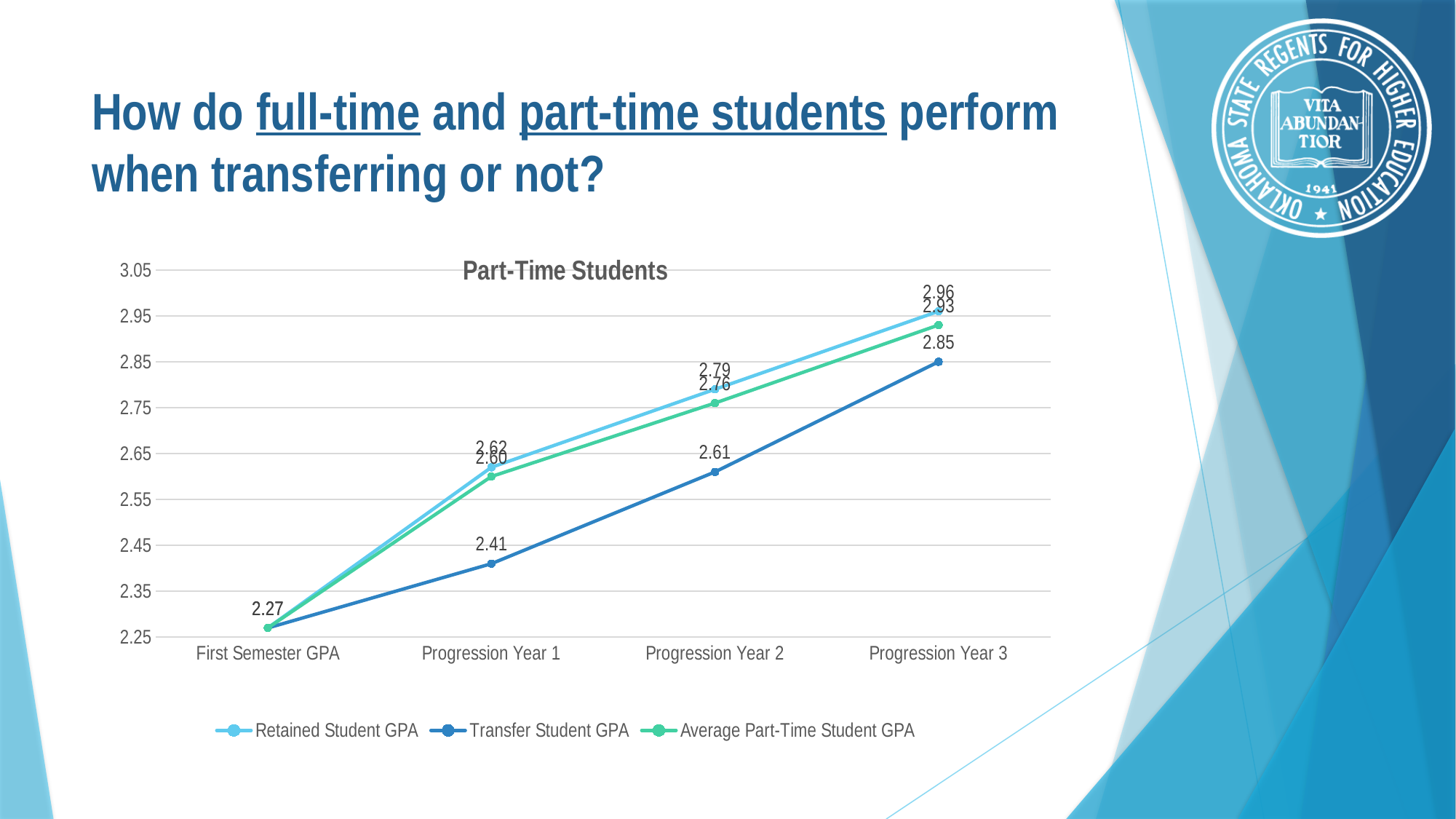
Which is larger at Progression Year 3, the Retained Student GPA or the Transfer Student GPA? Retained Student GPA Which series has the lowest value at Progression Year 1? Transfer Student GPA What is the Transfer Student GPA at Progression Year 3? 2.85 What is the Average Part-Time Student GPA at Progression Year 2? 2.76 How many series does the legend list? 3 What is the difference between the Retained Student GPA and the Transfer Student GPA at Progression Year 2? 0.18 What is the Transfer Student GPA at Progression Year 1? 2.41 Does the Transfer Student GPA rise or fall from First Semester GPA to Progression Year 3? rise What is the Retained Student GPA at Progression Year 3? 2.96 How many categories are shown on the x axis? 4 What is the title of the chart? Part-Time Students What type of chart is shown on the slide? line chart